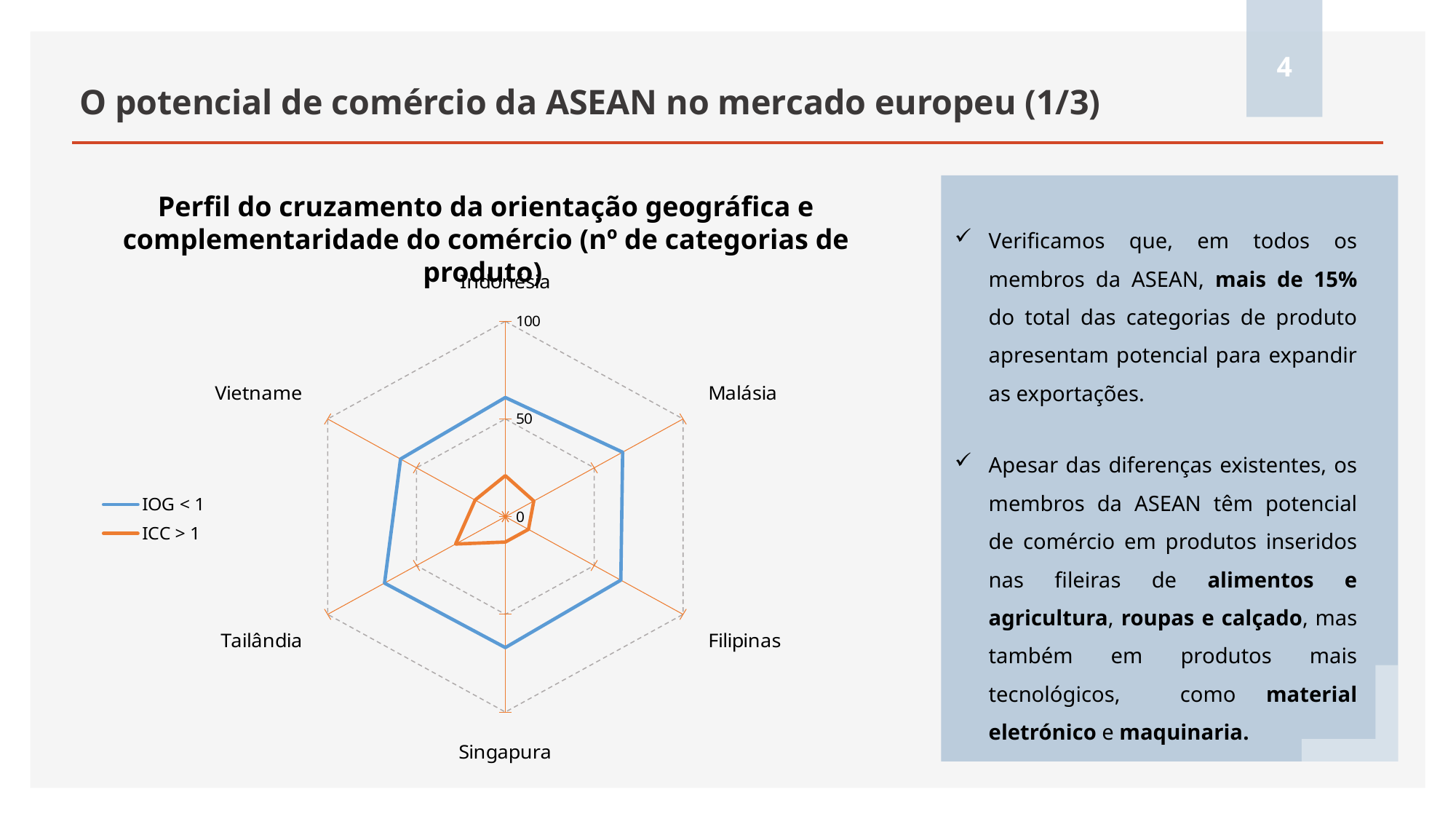
Is the IOG < 1 value for Indonésia greater or less than 50? greater What is the maximum value shown on the radar chart's axis? 100 Is the ICC > 1 value for Indonésia greater or less than 50? less Is the IOG < 1 value for Singapura greater or less than 50? greater What kind of chart is shown on the slide? Radar chart How many countries (categories) are plotted on the radar chart? 6 How many series does the legend of the radar chart list? 2 For Vietname, which series has the larger value, IOG < 1 or ICC > 1? IOG < 1 For Filipinas, which series has the larger value, IOG < 1 or ICC > 1? IOG < 1 Which colour represents the ICC > 1 series in the radar chart? Orange